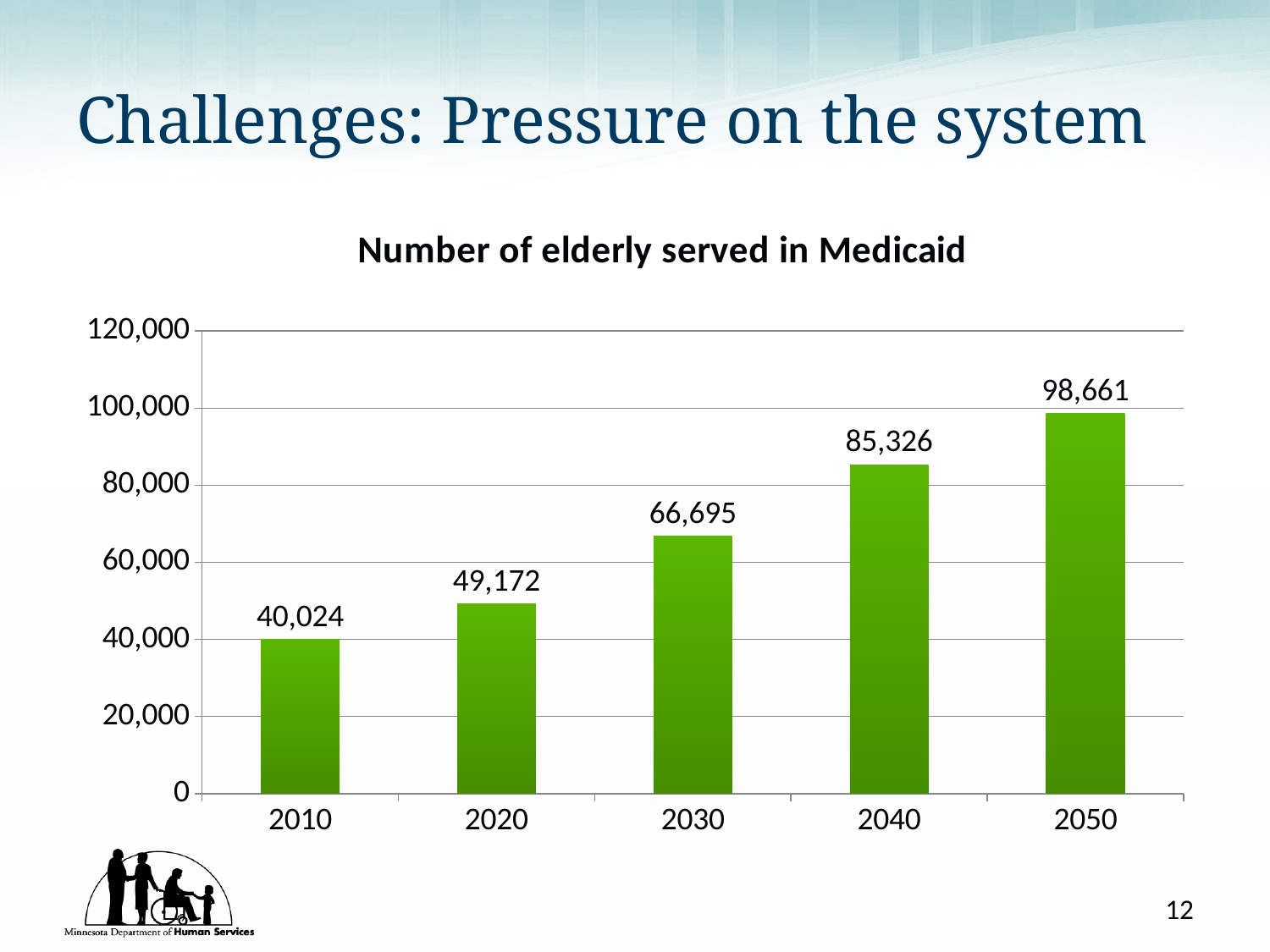
What is the number of elderly served in Medicaid in 2030? 66,695 What is the difference between the number of elderly served in 2050 and in 2010? 58,637 What is the number of elderly served in Medicaid in 2050? 98,661 What kind of chart is shown on the slide? Bar chart What is the number of elderly served in Medicaid in 2010? 40,024 What is the difference between the values for 2040 and 2030? 18,631 Which is larger, the value for 2020 or the value for 2040? 2040 Which year has the lowest number of elderly served in Medicaid? 2010 How many years are shown on the x axis of the chart? 5 Is the value for 2040 greater or less than 80,000? greater Do the values rise or fall from 2010 to 2050? Rise Which year has the highest number of elderly served in Medicaid? 2050